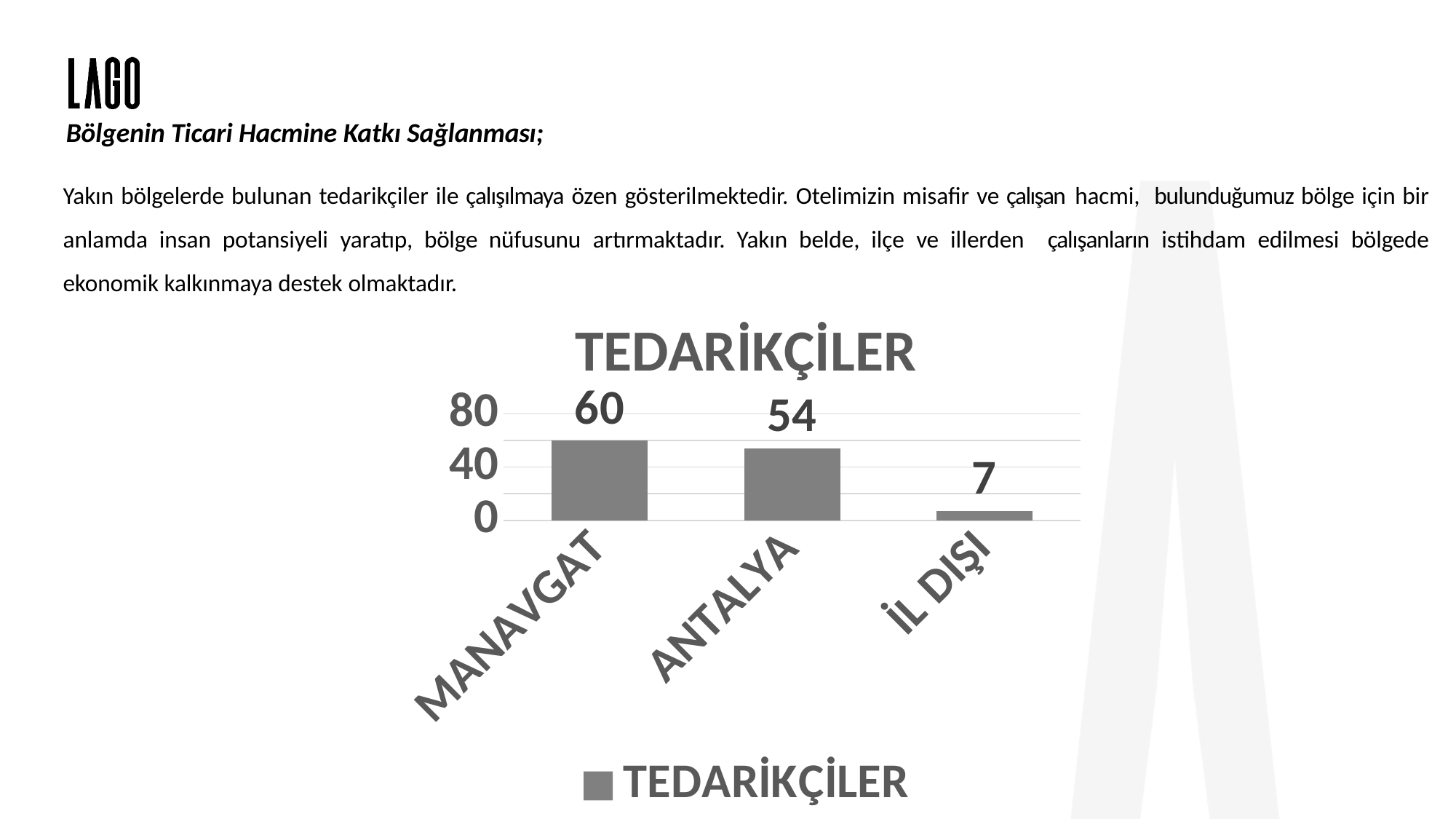
What kind of chart is shown on the slide? bar chart Which category has the lowest value in the TEDARİKÇİLER chart? İL DIŞI What is the value for İL DIŞI in the TEDARİKÇİLER chart? 7 What is the title of the chart on the slide? TEDARİKÇİLER How many categories are shown in the TEDARİKÇİLER chart? 3 What is the difference between the values for MANAVGAT and ANTALYA? 6 Which is larger, the value for MANAVGAT or the value for İL DIŞI? MANAVGAT What is the difference between the values for ANTALYA and İL DIŞI? 47 Which category has the highest value in the TEDARİKÇİLER chart? MANAVGAT Is the value for ANTALYA greater or less than 40? greater What is the value for ANTALYA in the TEDARİKÇİLER chart? 54 What is the value for MANAVGAT in the TEDARİKÇİLER chart? 60